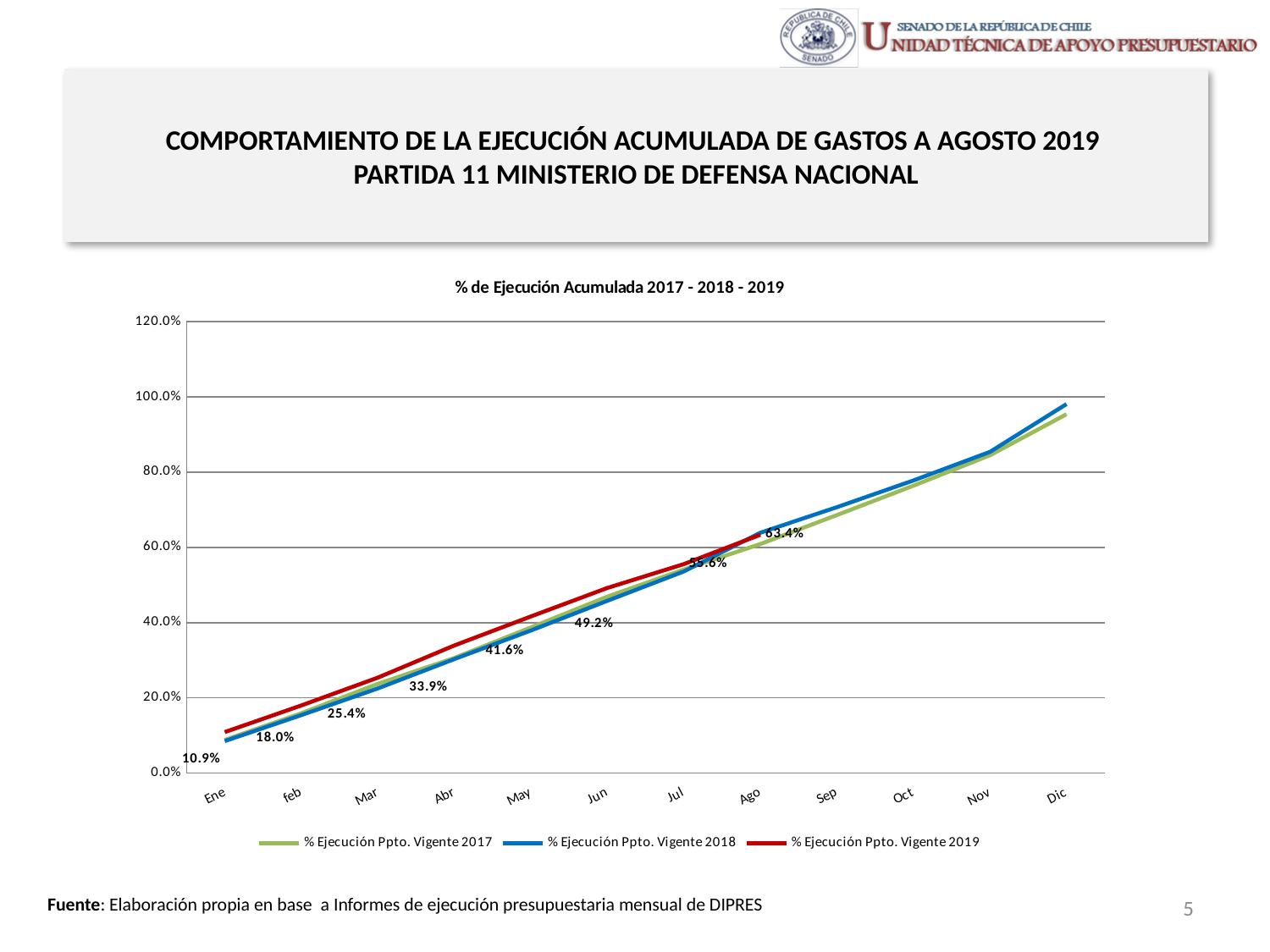
How many series does the legend list? 3 Which month has the highest value for % Ejecución Ppto. Vigente 2019? Ago What kind of chart is shown on the slide? line chart What is the value of % Ejecución Ppto. Vigente 2019 for Ene? 10.9% How many months are shown along the x axis? 12 What is the value of % Ejecución Ppto. Vigente 2019 for Abr? 33.9% Is the value for % Ejecución Ppto. Vigente 2018 in Dic greater or less than 80%? greater What is the title of the chart? % de Ejecución Acumulada 2017 - 2018 - 2019 What is the difference between the 2019 values for Ago and Jul? 7.8 percentage points Do the values of the 2019 series rise or fall from Ene to Ago? rise What is the value of % Ejecución Ppto. Vigente 2019 for Jun? 49.2% What is the value of % Ejecución Ppto. Vigente 2019 for Ago? 63.4%